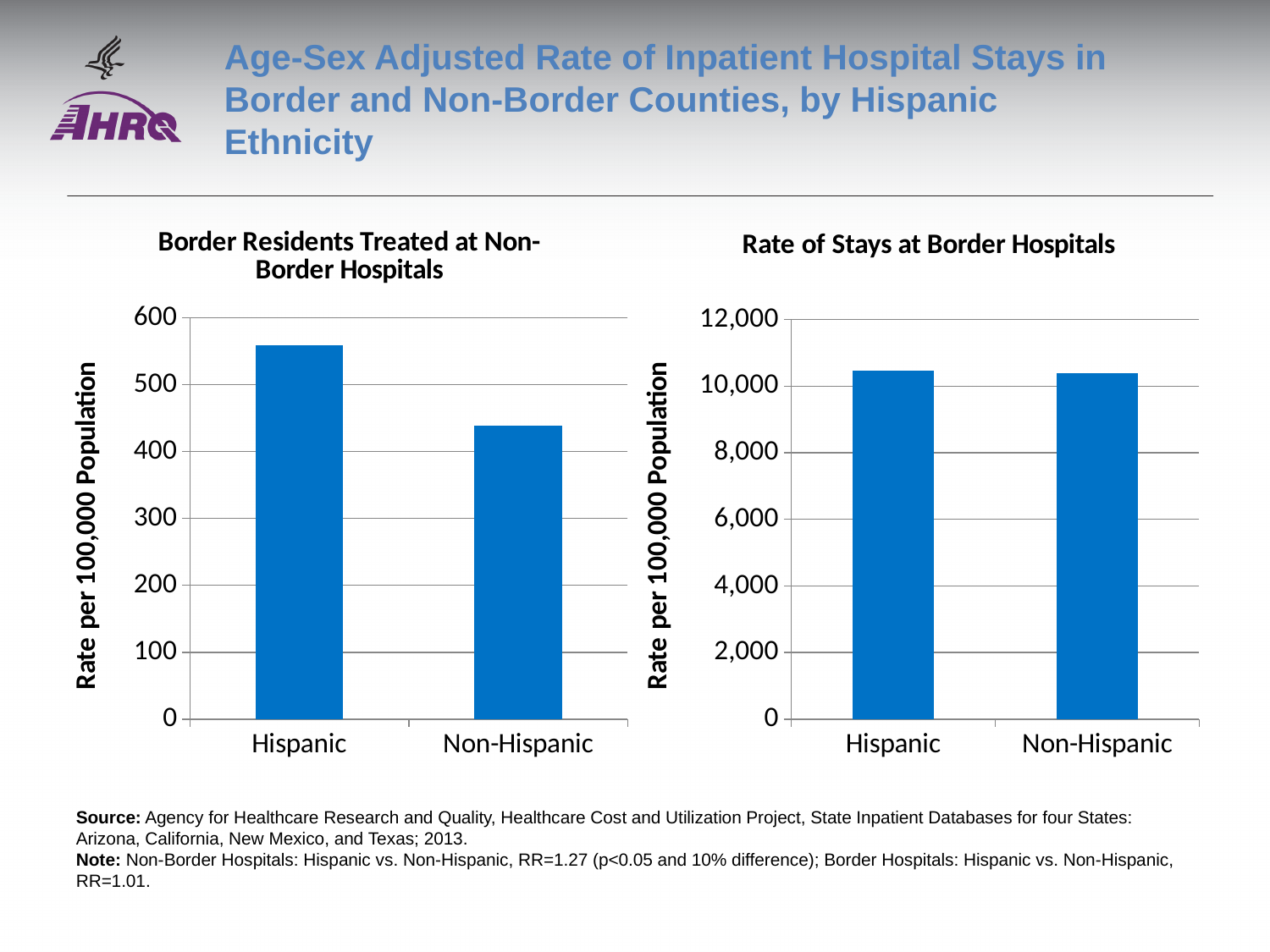
In the chart titled "Border Residents Treated at Non-Border Hospitals", is the value for Hispanic greater or less than 500? greater In the chart titled "Border Residents Treated at Non-Border Hospitals", is the value for Non-Hispanic greater or less than 400? greater What is the title of the chart on the left side of the slide? Border Residents Treated at Non-Border Hospitals In the chart titled "Border Residents Treated at Non-Border Hospitals", which category has the lowest rate? Non-Hispanic In the chart titled "Rate of Stays at Border Hospitals", is the value for Non-Hispanic greater or less than 12,000? less In the chart titled "Border Residents Treated at Non-Border Hospitals", which category has the highest rate? Hispanic In the chart titled "Border Residents Treated at Non-Border Hospitals", what kind of chart is shown? Bar chart In the chart titled "Border Residents Treated at Non-Border Hospitals", which is larger, the value for Hispanic or for Non-Hispanic? Hispanic What is the y-axis label of the chart titled "Rate of Stays at Border Hospitals"? Rate per 100,000 Population In the chart titled "Rate of Stays at Border Hospitals", how many categories are plotted? 2